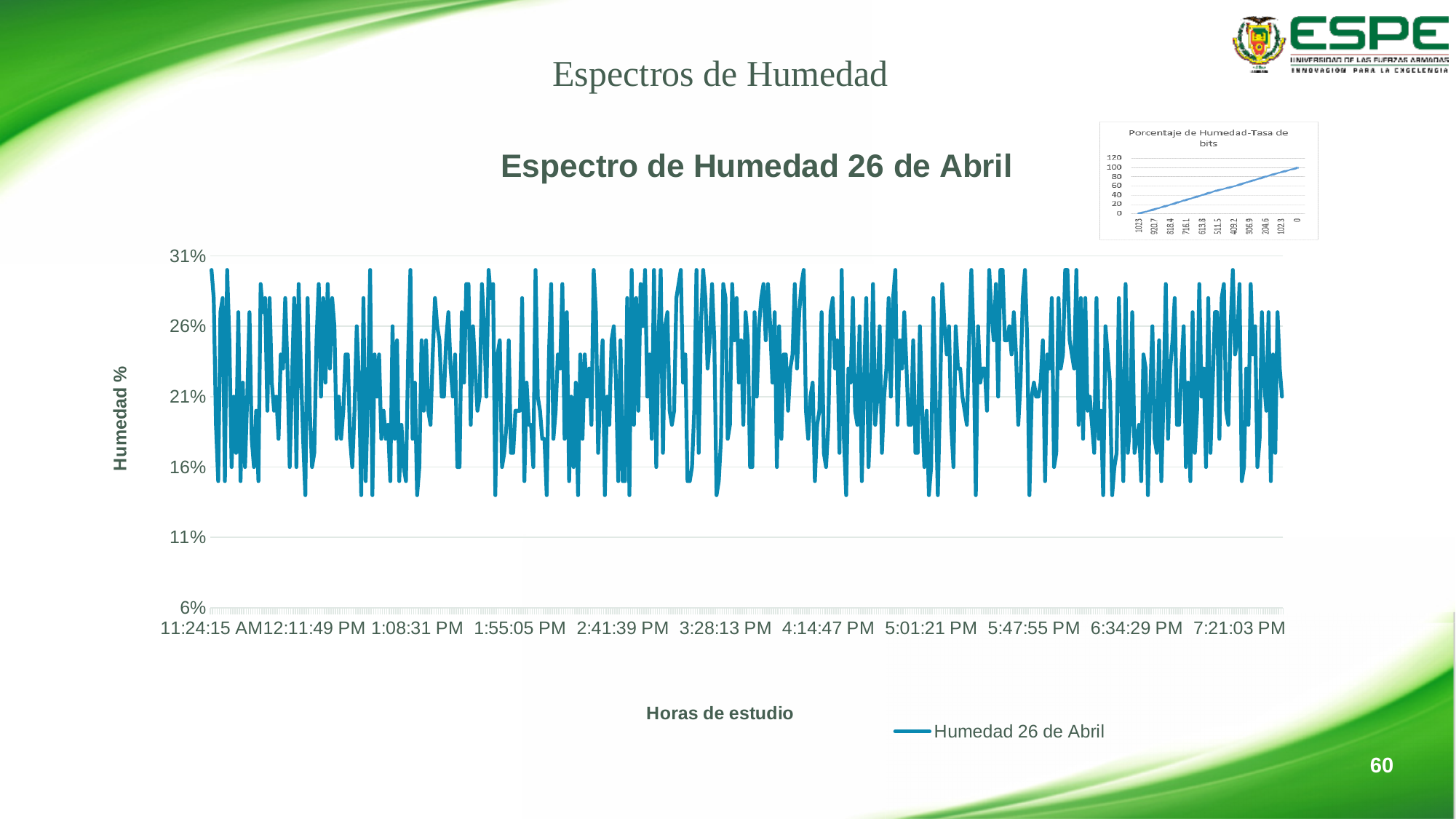
What kind of chart is the main chart titled "Espectro de Humedad 26 de Abril"? line chart How many series does the legend of the main chart "Espectro de Humedad 26 de Abril" list? 1 In the main chart "Espectro de Humedad 26 de Abril", what is the lowest value shown on the y axis? 6% What kind of chart is the small inset chart titled "Porcentaje de Humedad-Tasa de bits"? line chart In the small inset chart "Porcentaje de Humedad-Tasa de bits", do the values rise or fall along the x axis from left to right? rise In the main chart "Espectro de Humedad 26 de Abril", is the humidity value at 11:24:15 AM greater or less than 21%? greater In the main chart "Espectro de Humedad 26 de Abril", what is the last time shown on the x axis? 7:21:03 PM In the main chart "Espectro de Humedad 26 de Abril", what is the first time shown on the x axis? 11:24:15 AM What is the y-axis label of the main chart "Espectro de Humedad 26 de Abril"? Humedad % How many charts are shown on the slide? 2 In the main chart "Espectro de Humedad 26 de Abril", what is the highest value shown on the y axis? 31% What is the legend entry of the main chart "Espectro de Humedad 26 de Abril"? Humedad 26 de Abril